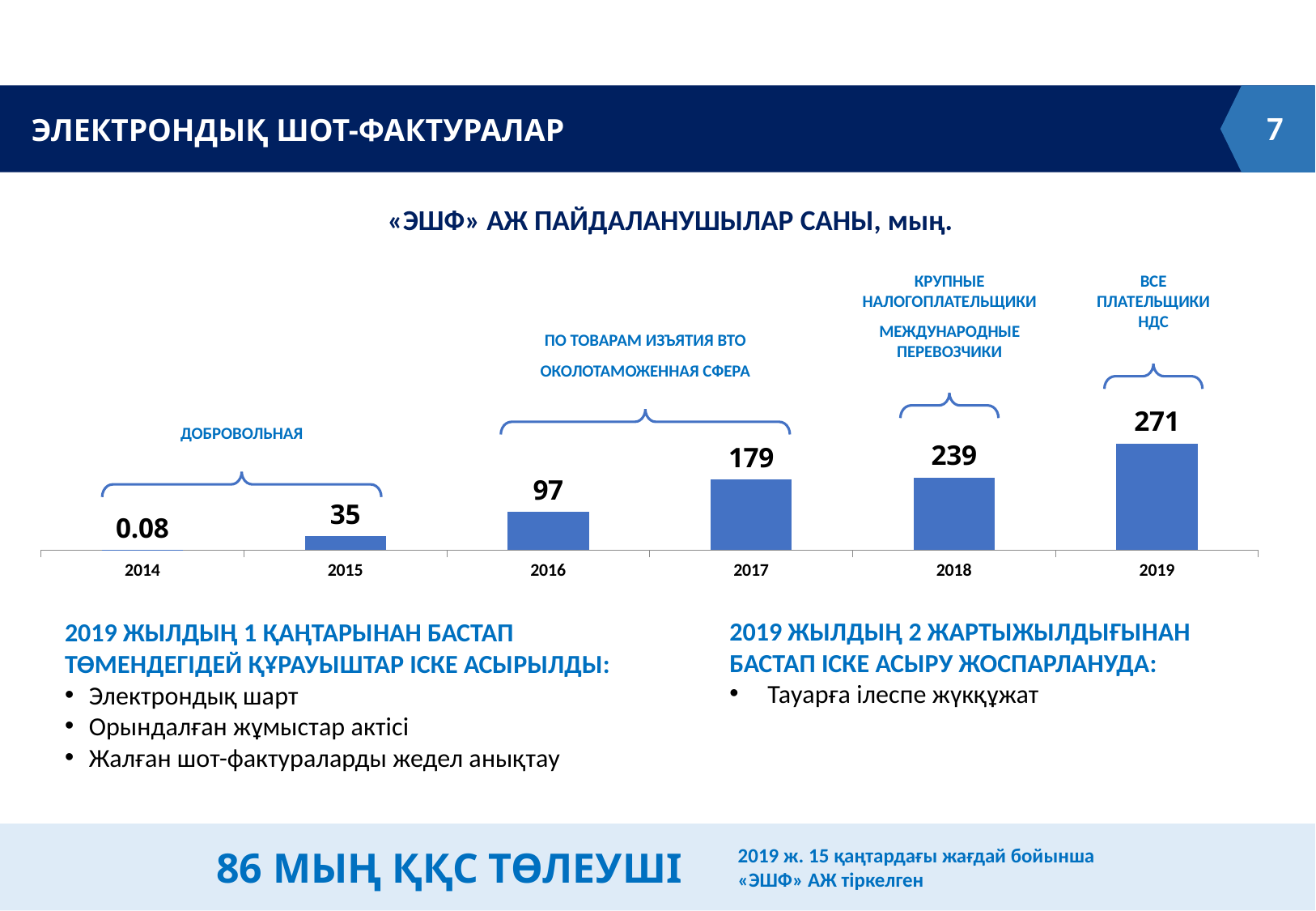
What is the difference between the values for 2019 and 2018? 32 What is the difference between the values for 2017 and 2016? 82 What is the value for 2016? 97 What kind of chart is this? bar chart How many years are shown on the x axis? 6 Do the values rise or fall from 2014 to 2019? rise Which is larger, the value for 2017 or the value for 2018? 2018 What is the title of the chart? «ЭШФ» АЖ ПАЙДАЛАНУШЫЛАР САНЫ, мың. Which year has the highest value? 2019 What is the value for 2019? 271 What is the value for 2014? 0.08 Which year has the lowest value? 2014